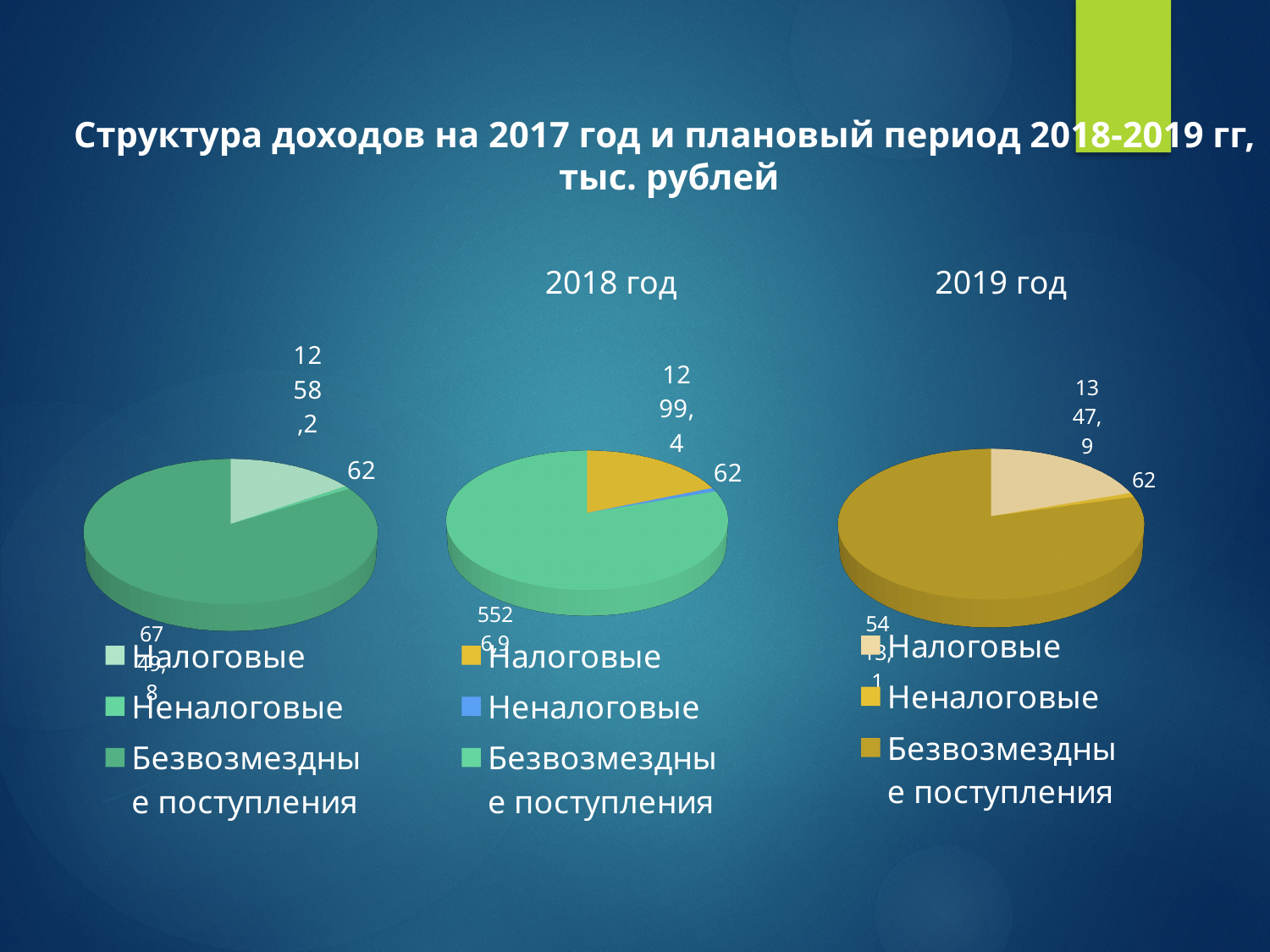
How many pie charts are shown on the slide? 3 In the pie chart titled 2018 год, what is the value for Налоговые? 1299,4 In the pie chart titled 2019 год, what is the value for Налоговые? 1347,9 In the pie chart titled 2019 год, which is larger: Налоговые or Неналоговые? Налоговые In the pie chart titled 2019 год, what is the difference between the values for Налоговые and Неналоговые? 1285,9 In the pie chart titled 2019 год, which category has the smallest slice? Неналоговые In the leftmost pie chart, what is the value for Налоговые? 1258,2 In the pie chart titled 2018 год, what is the value for Неналоговые? 62 In the pie chart titled 2019 год, what is the value for Неналоговые? 62 What kind of chart is the chart titled 2019 год? pie chart In the pie chart titled 2018 год, which category has the largest slice? Безвозмездные поступления In the pie chart titled 2019 год, how many categories are shown? 3